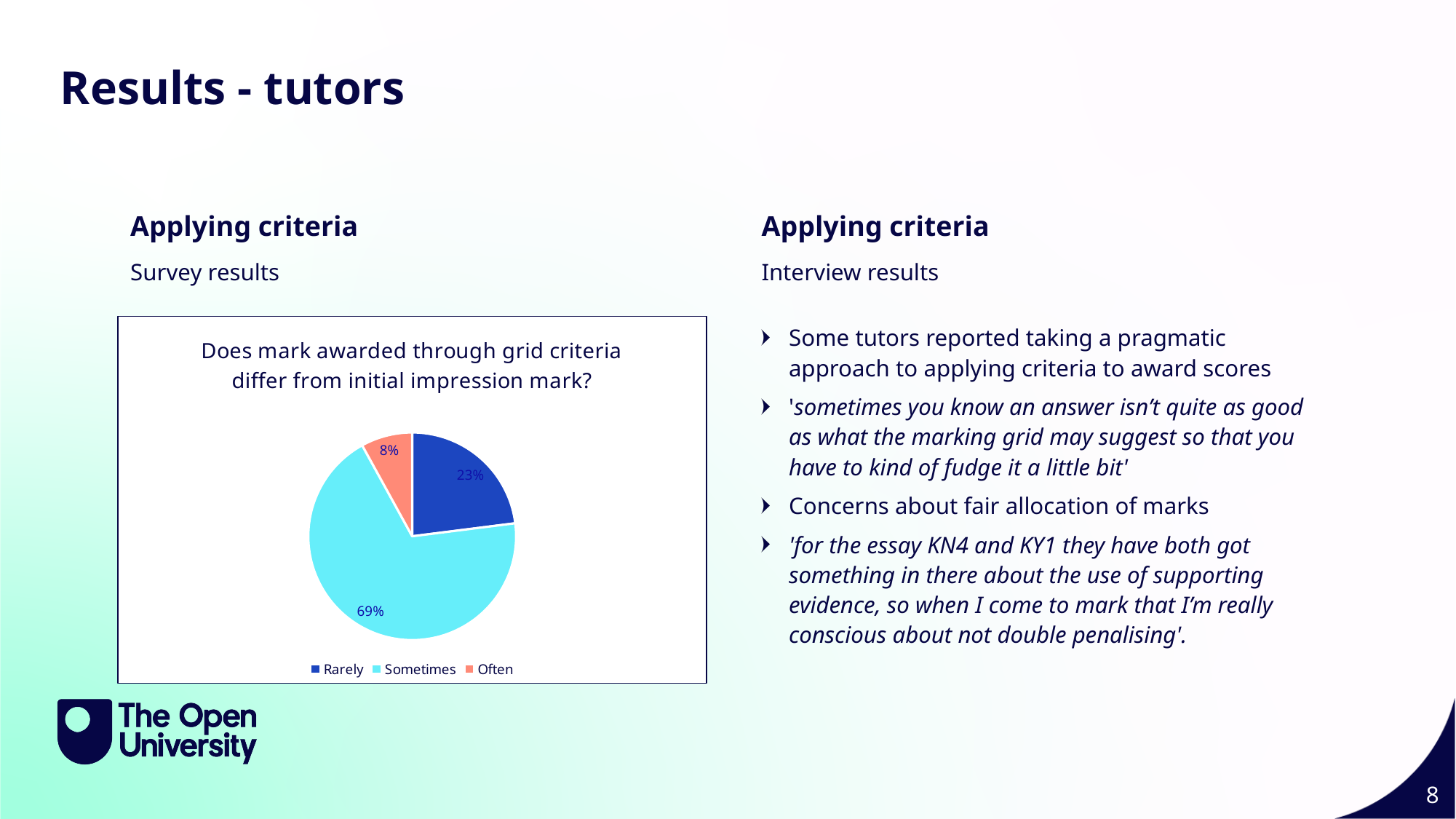
What is the title of the pie chart? Does mark awarded through grid criteria differ from initial impression mark? How many categories does the pie chart legend list? 3 What is the difference in percentage points between the 'Sometimes' and 'Rarely' slices? 46 What percentage of the pie is labelled 'Often'? 8% What colour is the 'Often' slice in the pie chart? orange/salmon Which category has the smallest slice of the pie? Often Which slice is larger, 'Rarely' or 'Often'? Rarely Which category has the largest slice of the pie? Sometimes What percentage of the pie is labelled 'Sometimes'? 69% What percentage of the pie is labelled 'Rarely'? 23% What kind of chart is shown on the slide? pie chart What is the difference in percentage points between the 'Rarely' and 'Often' slices? 15